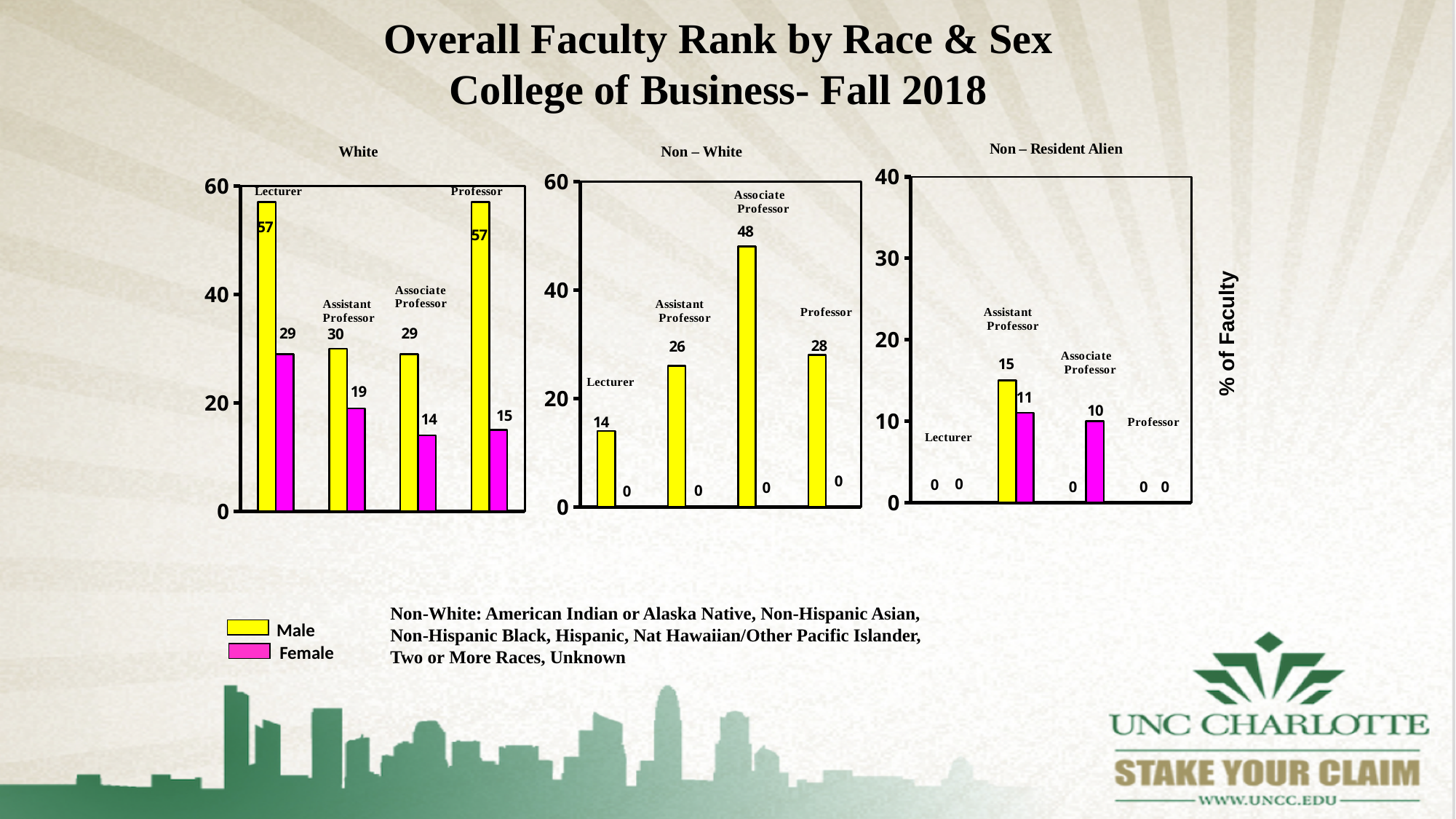
In the Non – Resident Alien chart, is the Male value for Assistant Professor greater or less than 10? greater How many series does the legend list? 2 In the White chart, what is the Male value for Lecturer? 57 In the White chart, what is the Female value for Assistant Professor? 19 How many faculty ranks are shown in the Non – White chart? 4 In the White chart, which rank has the lowest Female value? Associate Professor In the White chart, what is the difference between the Male and Female values for Professor? 42 In the Non – White chart, what is the Male value for Associate Professor? 48 In the Non – White chart, which rank has the highest Male value? Associate Professor In the Non – White chart, which is larger, the Male value for Assistant Professor or the Male value for Professor? Professor What type of chart is the White chart? Bar chart In the Non – Resident Alien chart, what is the Female value for Assistant Professor? 11